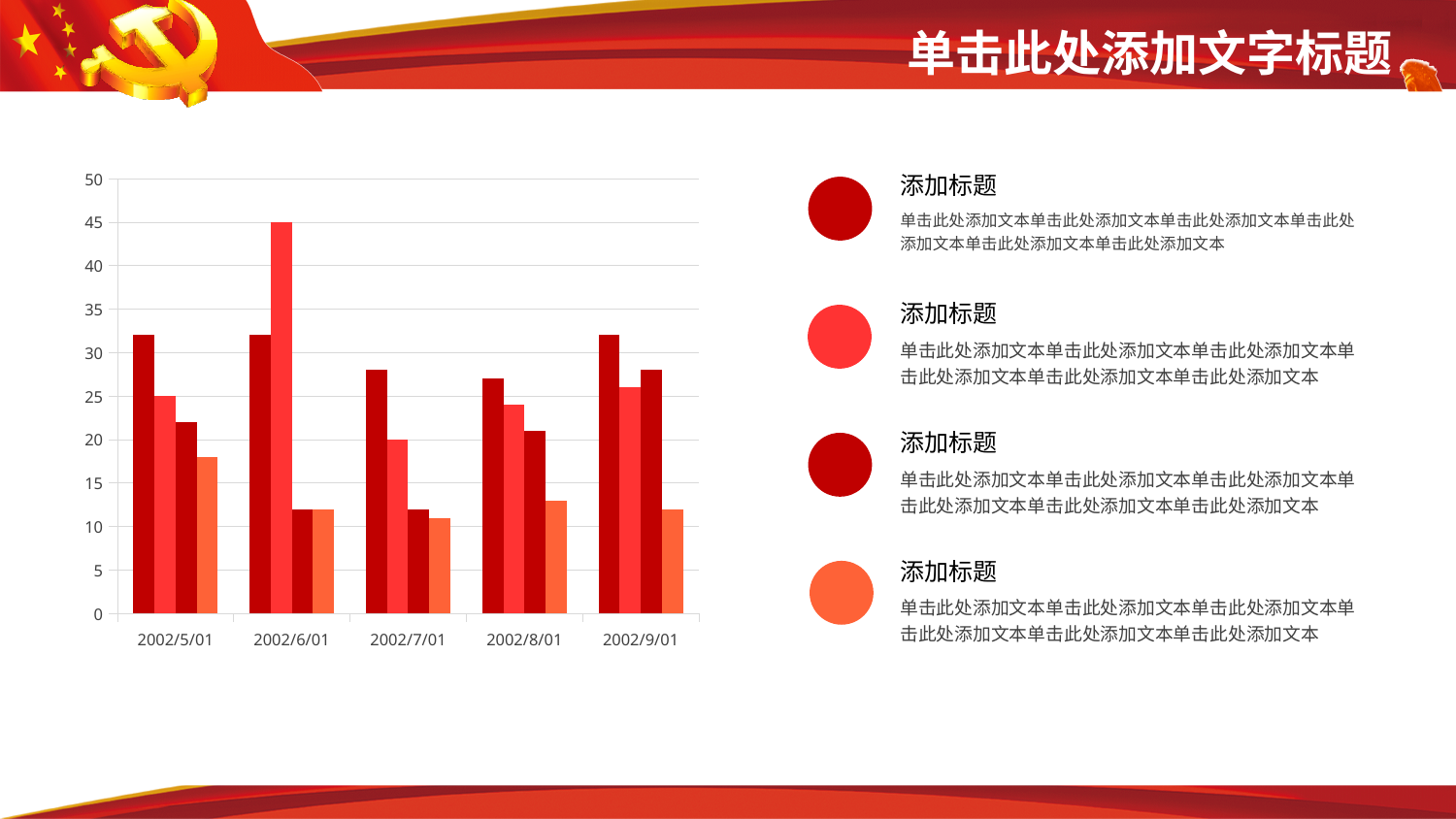
How many date categories are shown on the x axis of the chart? 5 Is the first (dark red) bar in the 2002/8/01 group greater or less than 25? greater Which is larger: the first (dark red) bar for 2002/5/01 or the first (dark red) bar for 2002/7/01? 2002/5/01 Which is larger: the second (bright red) bar for 2002/6/01 or the second (bright red) bar for 2002/8/01? 2002/6/01 What is the highest value shown on the chart's vertical axis? 50 Is the last (orange) bar in the 2002/5/01 group greater or less than 15? greater How many bars are plotted for each date category in the chart? 4 Is the first (dark red) bar in the 2002/5/01 group greater or less than 30? greater Which date category contains the tallest bar in the chart? 2002/6/01 What kind of chart is shown on the slide? bar chart